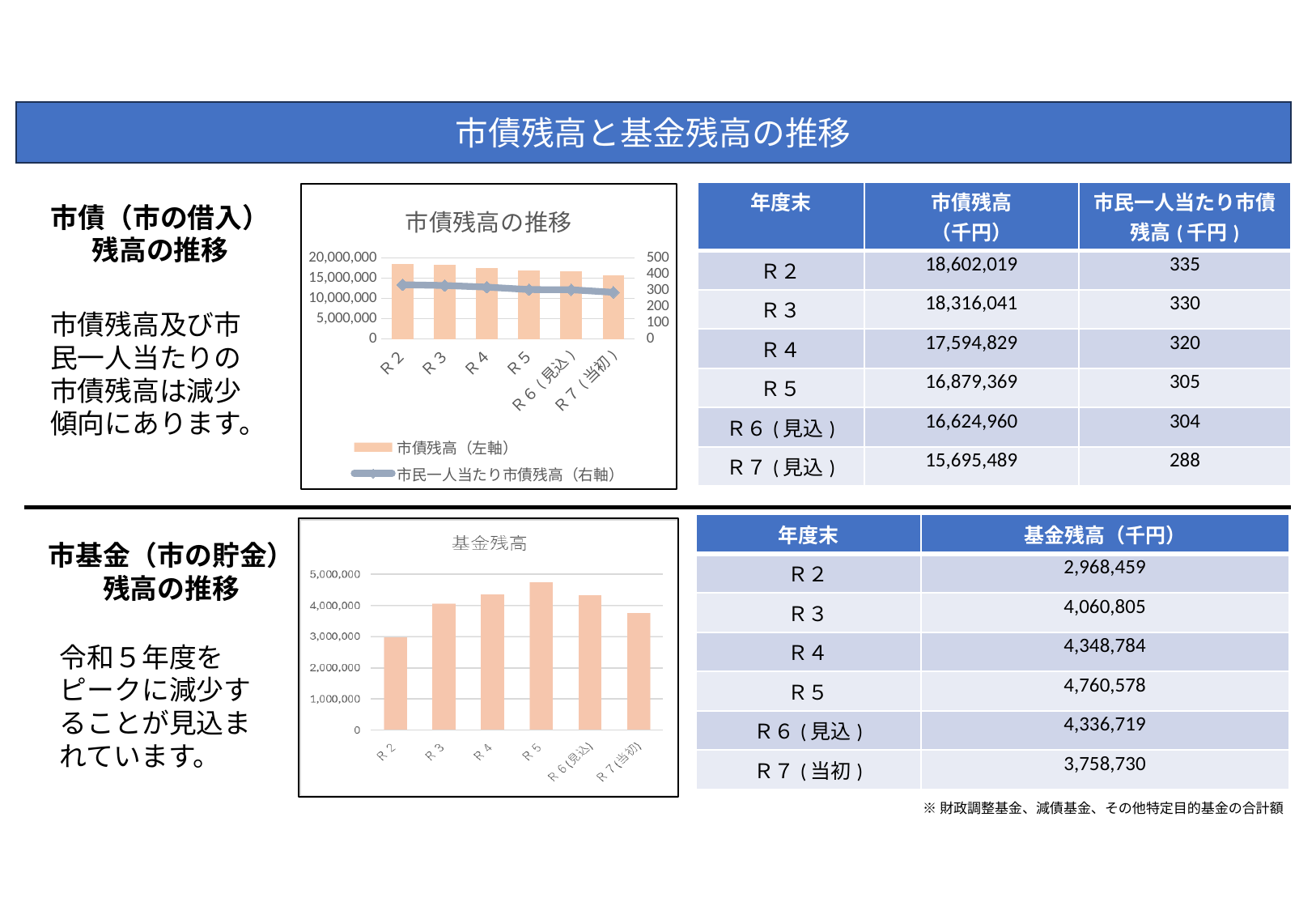
In the 基金残高 chart, is the value for R5 greater or less than 4,000,000? greater What is the 基金残高 (千円) for R5 shown on the slide? 4,760,578 What kind of chart is the 基金残高 chart at the bottom of the slide? bar chart In the 基金残高 chart, which year has the lowest value? R2 What is the 市民一人当たり市債残高 (千円) for R5 shown on the slide? 305 In the 市債残高の推移 chart, do the 市債残高 bars rise or fall from R2 to R7? fall In the 基金残高 chart, which year has the highest value? R5 How many series does the legend of the 市債残高の推移 chart list? 2 How many categories are shown on the x axis of the 市債残高の推移 chart? 6 In the 市債残高の推移 chart, which year has the highest 市債残高? R2 What is the difference in 市債残高 (千円) between R2 and R3? 285,978 What is the 市債残高 (千円) for R2 shown on the slide? 18,602,019